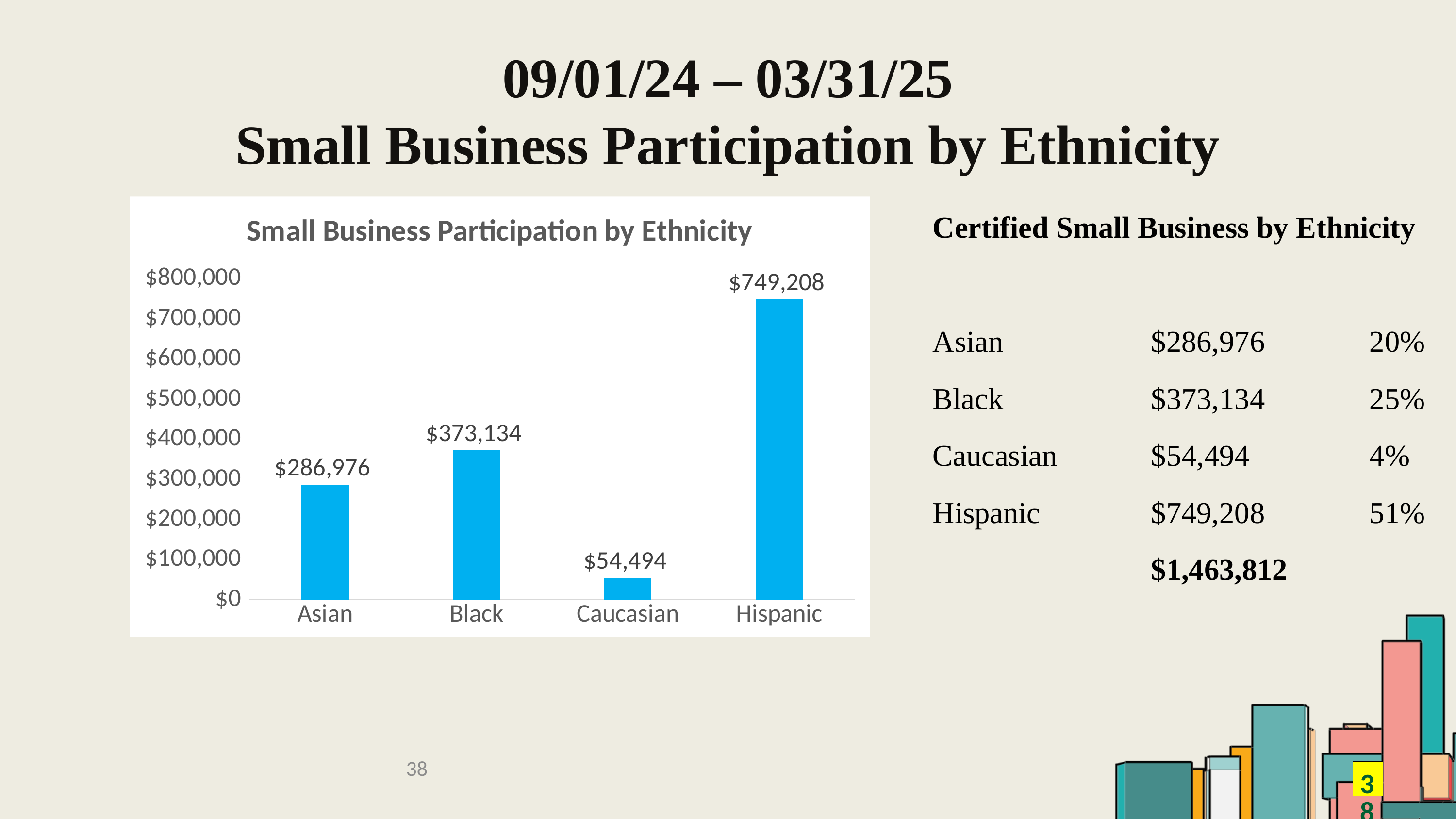
What is the title of the chart? Small Business Participation by Ethnicity Is the value for Hispanic greater or less than $700,000? greater How many categories are shown in the chart? 4 What is the difference between the values for Hispanic and Black? $376,074 What is the value for Hispanic in the chart? $749,208 Which category has the lowest value in the chart? Caucasian Which category has the highest value in the chart? Hispanic Which is larger, the value for Black or the value for Asian? Black What kind of chart is shown on the slide? bar chart What is the value for Asian in the chart? $286,976 What is the difference between the values for Black and Asian? $86,158 What is the value for Caucasian in the chart? $54,494